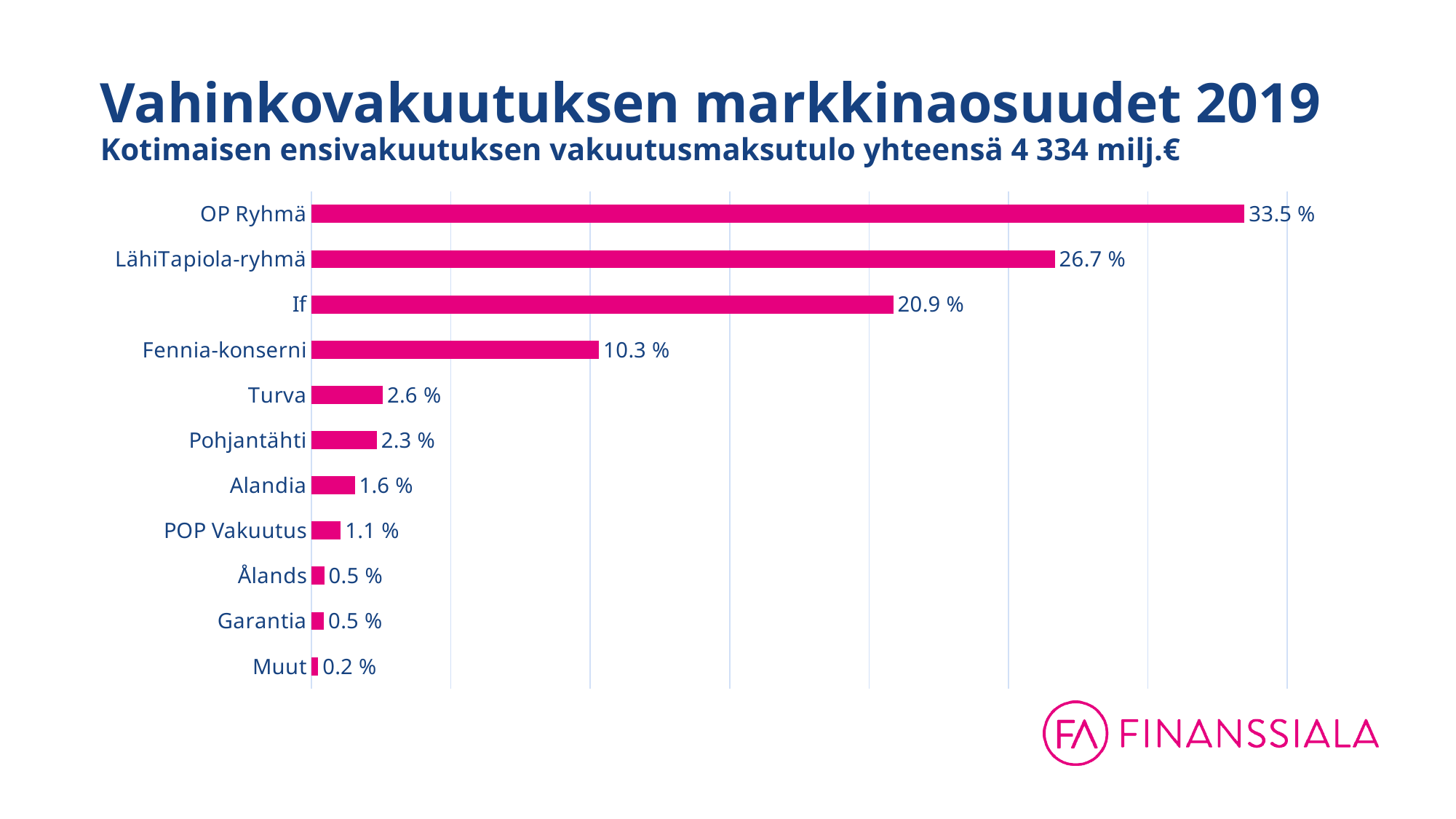
What kind of chart is shown on the slide? Bar chart Which is larger, the value for Turva or the value for Pohjantähti? Turva What is the value shown for Fennia-konserni? 10.3 % Which category has the lowest value? Muut What is the difference between the values for OP Ryhmä and LähiTapiola-ryhmä? 6.8 % How many categories are shown in the chart? 11 What is the market share shown for OP Ryhmä? 33.5 % What total premium income is stated in the subtitle? 4 334 milj.€ What is the difference between the values for If and Fennia-konserni? 10.6 % What is the value shown for POP Vakuutus? 1.1 % Which category has the highest value? OP Ryhmä What is the title of the chart? Vahinkovakuutuksen markkinaosuudet 2019